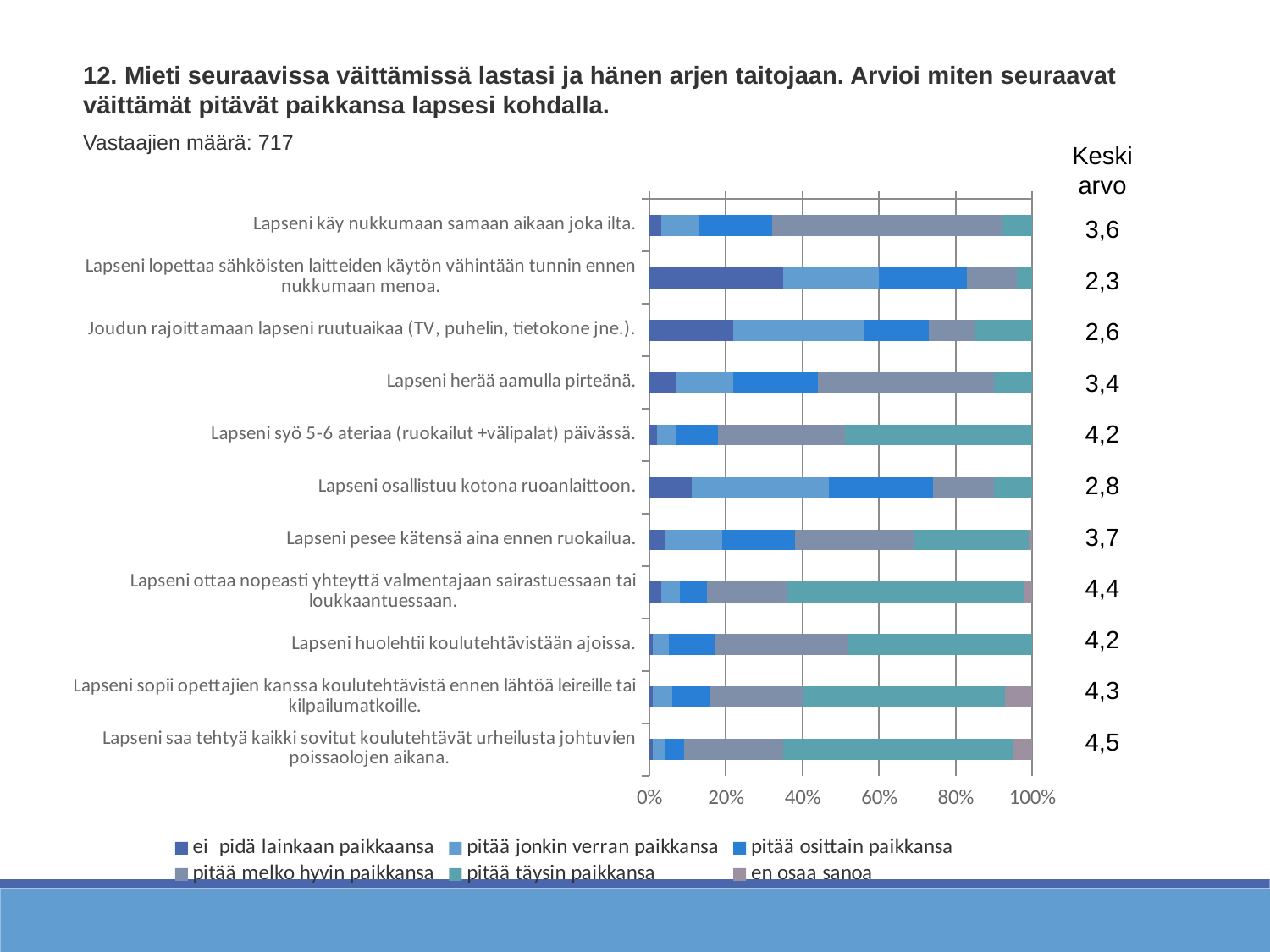
Which statement has the highest Keskiarvo value? Lapseni saa tehtyä kaikki sovitut koulutehtävät urheilusta johtuvien poissaolojen aikana. What kind of chart is shown on the slide? Stacked bar chart How many respondents (Vastaajien määrä) are reported on the slide? 717 What is the difference between the highest Keskiarvo value (4,5) and the lowest (2,3)? 2,2 Which has the larger Keskiarvo value: "Lapseni herää aamulla pirteänä." or "Lapseni pesee kätensä aina ennen ruokailua."? Lapseni pesee kätensä aina ennen ruokailua. What is the Keskiarvo value shown for "Lapseni osallistuu kotona ruoanlaittoon."? 2,8 How many statements (bars) are shown in the chart? 11 What is the Keskiarvo value shown for "Lapseni ottaa nopeasti yhteyttä valmentajaan sairastuessaan tai loukkaantuessaan."? 4,4 Which statement has the lowest Keskiarvo value? Lapseni lopettaa sähköisten laitteiden käytön vähintään tunnin ennen nukkumaan menoa. How many series does the legend list? 6 What is the Keskiarvo (mean) value shown for "Lapseni käy nukkumaan samaan aikaan joka ilta."? 3,6 Is the "ei pidä lainkaan paikkaansa" share for "Lapseni lopettaa sähköisten laitteiden käytön vähintään tunnin ennen nukkumaan menoa." greater or less than 20%? greater